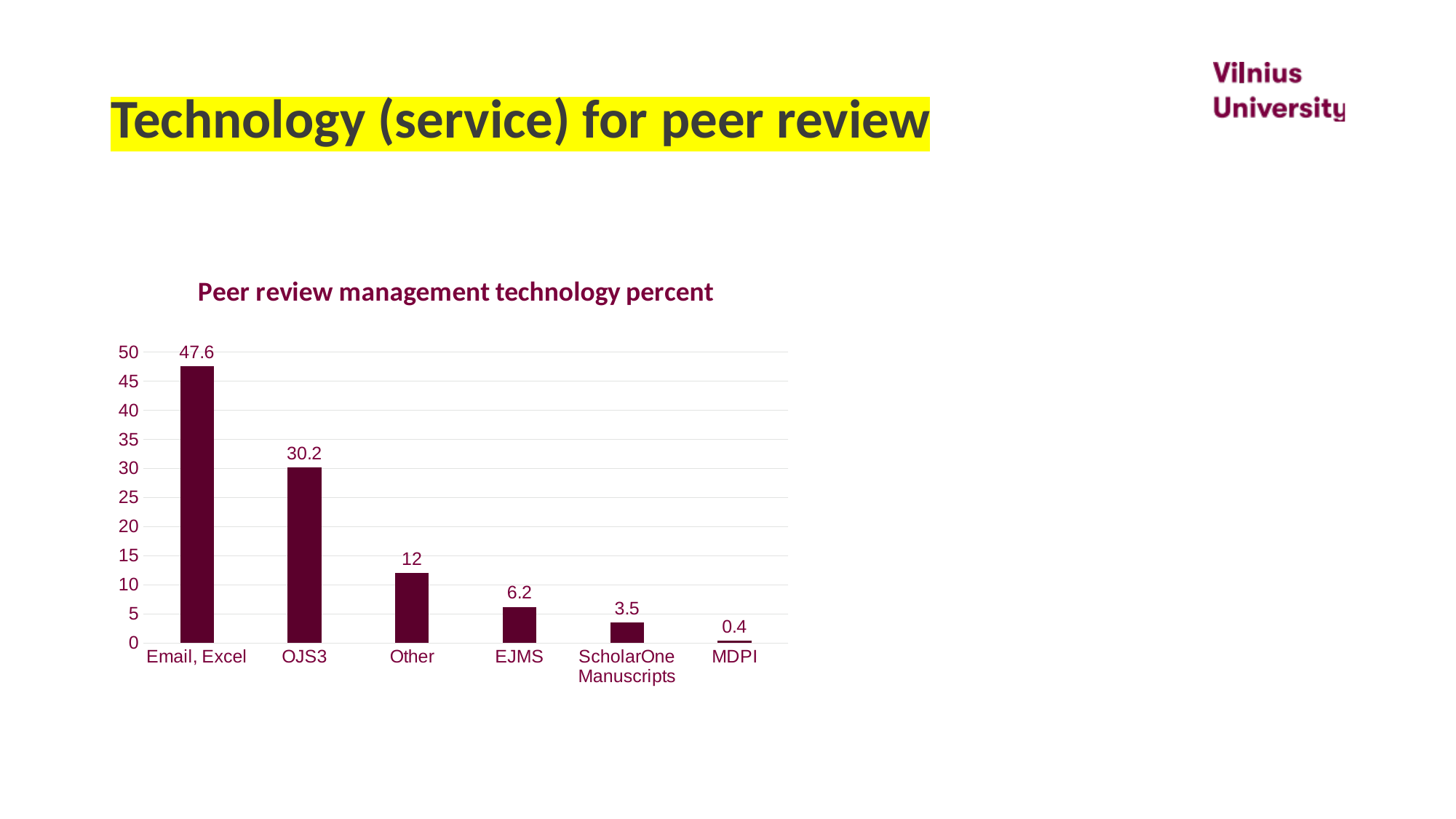
What is the value for MDPI? 0.4 What kind of chart is shown on the slide? Bar chart Which is larger, the value for EJMS or the value for ScholarOne Manuscripts? EJMS What is the value for OJS3? 30.2 Which category has the highest value? Email, Excel What is the title of the chart? Peer review management technology percent Which category has the lowest value? MDPI What is the difference between the values for Email, Excel and OJS3? 17.4 What is the value for ScholarOne Manuscripts? 3.5 What is the difference between the values for Other and EJMS? 5.8 What is the value for Email, Excel? 47.6 How many categories are shown on the x axis? 6